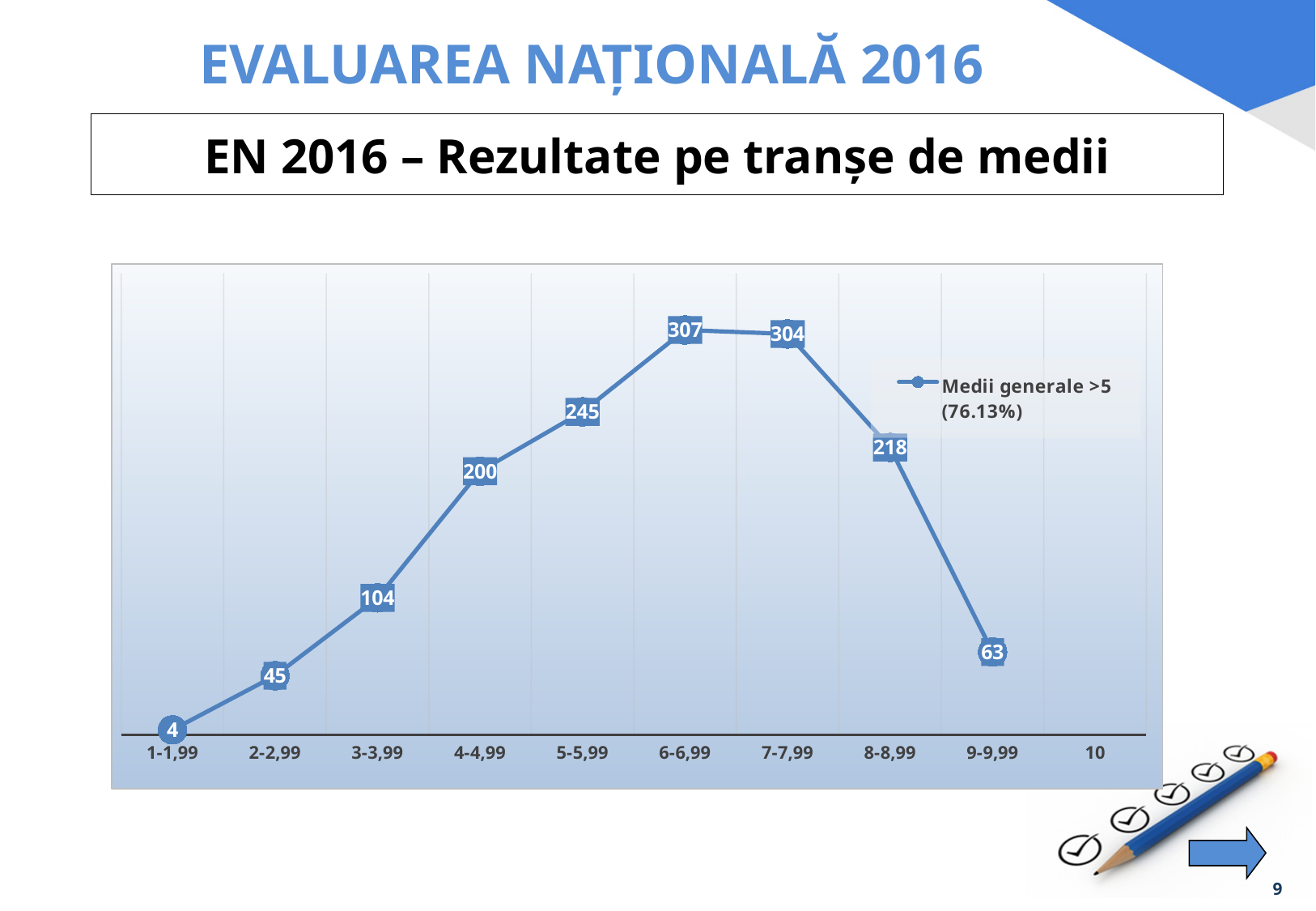
Which is larger, the value for 2-2,99 or the value for 3-3,99? 3-3,99 What kind of chart is shown on the slide? line chart How many category labels are shown on the x axis? 10 What is the value for the 6-6,99 band? 307 What is the value for the 9-9,99 band? 63 What is the difference between the values for 8-8,99 and 9-9,99? 155 How many series does the legend list? 1 What is the difference between the values for 5-5,99 and 4-4,99? 45 Which band has the lowest value? 1-1,99 What is the value for the 3-3,99 band? 104 Which band has the highest value? 6-6,99 What is the legend entry for the plotted series? Medii generale >5 (76.13%)